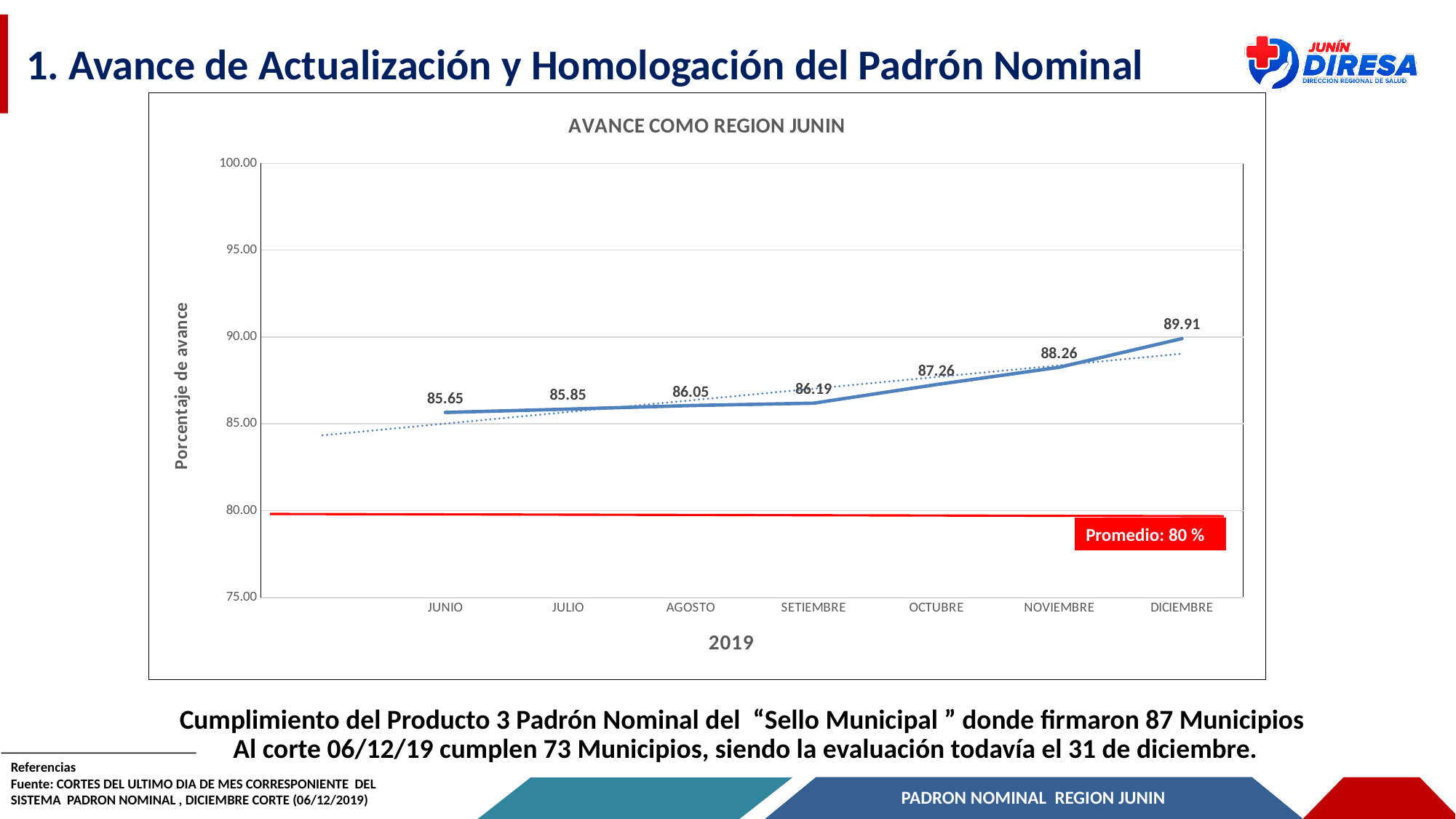
Which is larger, the value for OCTUBRE or the value for AGOSTO? OCTUBRE Do the values rise or fall from JUNIO to DICIEMBRE? rise What is the title of the chart? AVANCE COMO REGION JUNIN What is the value for DICIEMBRE? 89.91 What type of chart is shown on the slide? line chart What is the difference between the values for DICIEMBRE and NOVIEMBRE? 1.65 What is the value for JUNIO? 85.65 Which month has the lowest value? JUNIO Which month has the highest value? DICIEMBRE What is the value for SETIEMBRE? 86.19 How many months are plotted on the x axis? 7 What value does the red horizontal line labelled 'Promedio' represent? 80 %